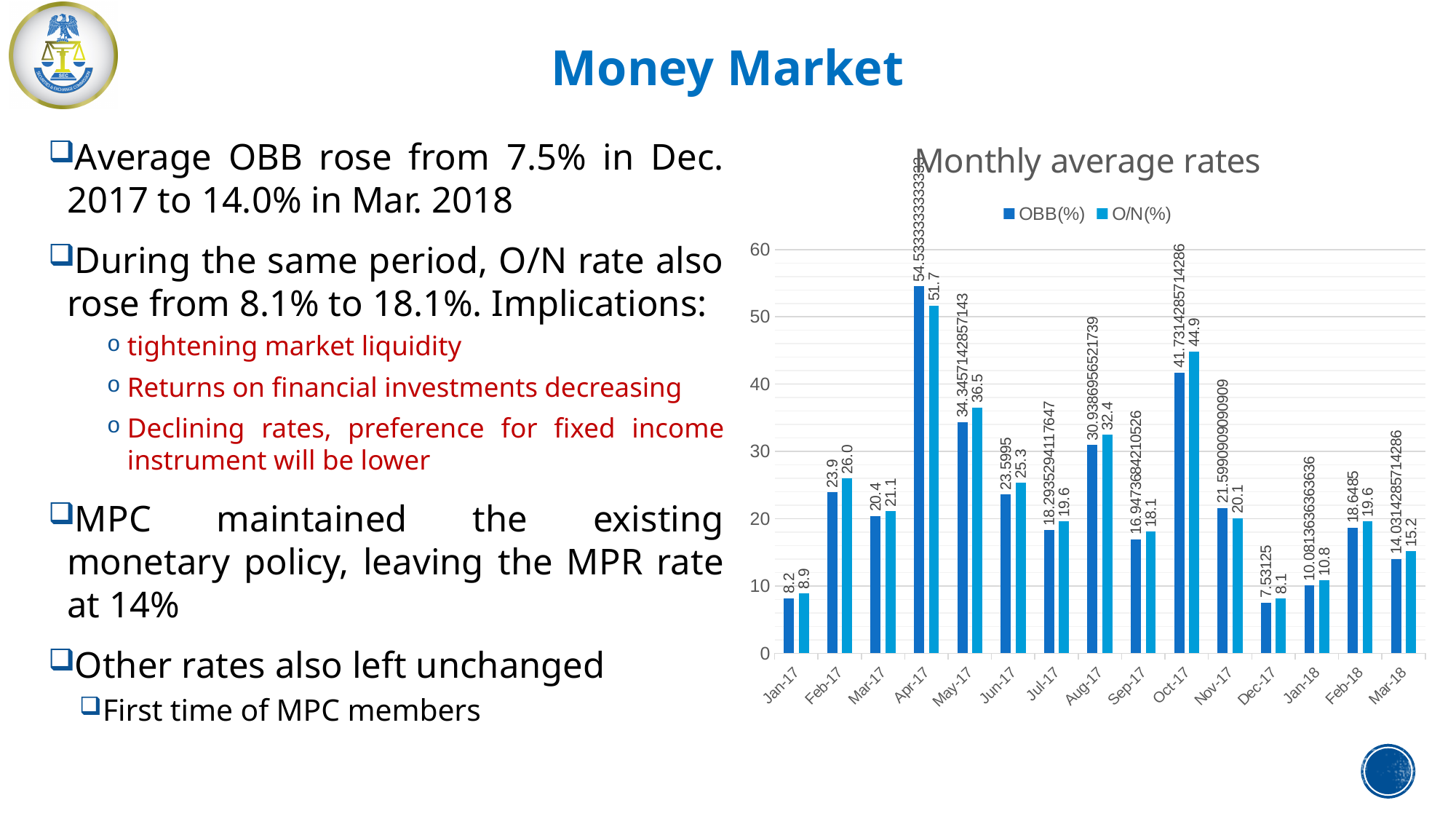
Which month has the highest O/N(%) value? Apr-17 For Nov-17, which is larger: the OBB(%) value or the O/N(%) value? OBB(%) Which month has the lowest OBB(%) value? Dec-17 Is the OBB(%) value for Oct-17 greater or less than 40? greater How many months are shown on the x axis of the chart? 15 What is the title of the chart? Monthly average rates How many series does the chart legend list? 2 What is the difference between the O/N(%) and OBB(%) values for Feb-17? 2.1 What is the O/N(%) value for Apr-17? 51.7 What is the OBB(%) value for Jan-17? 8.2 What is the O/N(%) value for Mar-18? 15.2 What kind of chart is shown on the slide? Bar chart